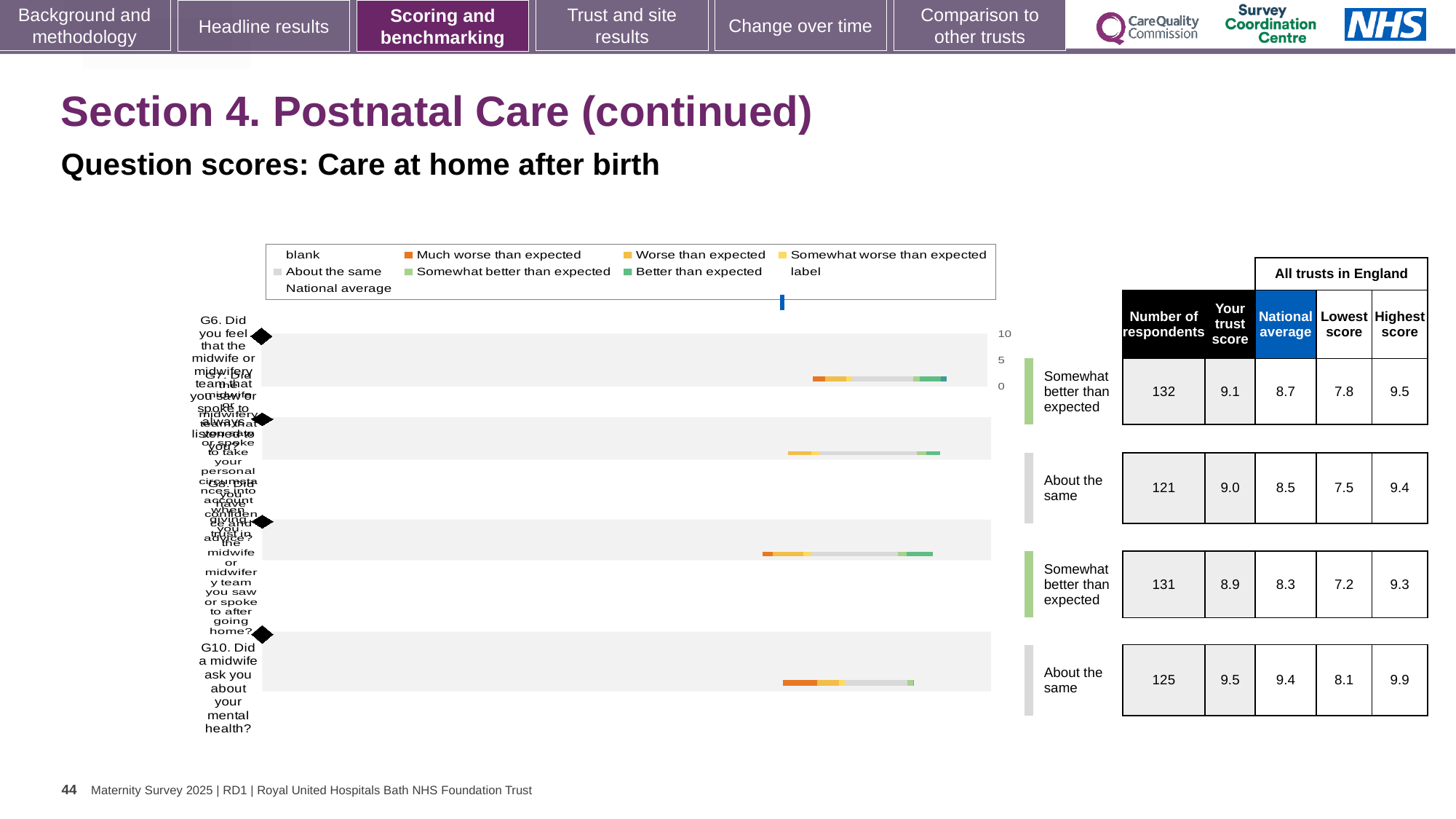
In the table beside the chart, what is the highest score for G10 (the last row)? 9.9 In the table beside the chart, what is the difference between the trust score and the national average for G6 (the first row)? 0.4 In the table beside the chart, what is the national average for G6 (the first row)? 8.7 In the table beside the chart, which row has the lowest number of respondents? The second row (121 respondents) In the table beside the chart, what is the trust score for G10 (Did a midwife ask you about your mental health?)? 9.5 In the table beside the chart, which row has the highest trust score? G10 (Did a midwife ask you about your mental health?) In the chart legend, what colour represents 'Much worse than expected'? Orange In the table beside the chart, is the trust score for G10 larger or smaller than the national average for G10? Larger In the chart legend, what colour represents 'Better than expected'? Green In the table beside the chart, what is the number of respondents for G10 (Did a midwife ask you about your mental health?)? 125 How many question bars are plotted in the chart? 4 What kind of chart is shown on the slide? Bar chart